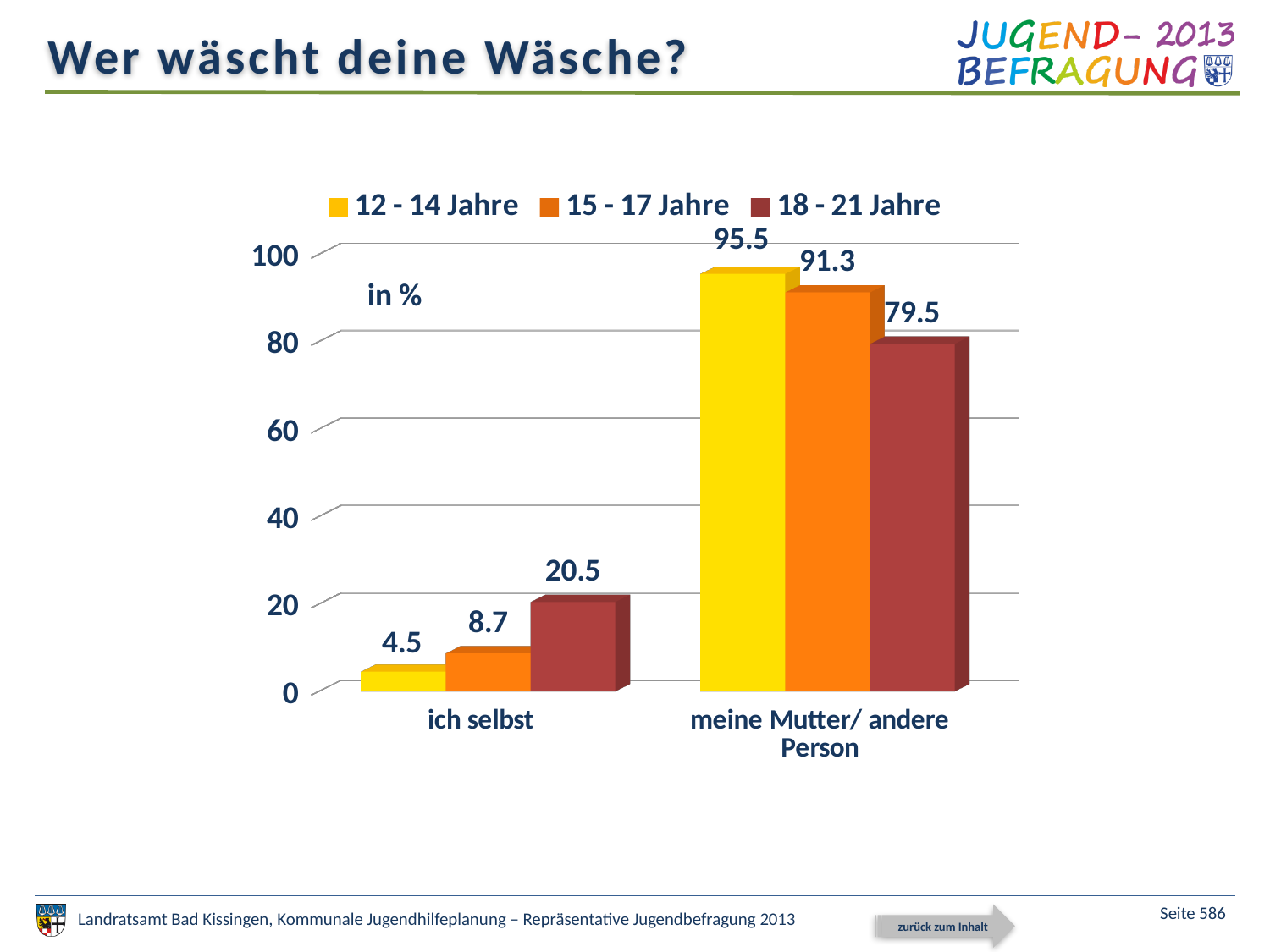
Which age group has the lowest value in the 'ich selbst' category? 12 - 14 Jahre Which age group has the highest value in the 'meine Mutter/ andere Person' category? 12 - 14 Jahre Which is larger: the '15 - 17 Jahre' value for 'ich selbst' or the '18 - 21 Jahre' value for 'ich selbst'? 18 - 21 Jahre What is the difference between the '12 - 14 Jahre' and '18 - 21 Jahre' values in the 'meine Mutter/ andere Person' category? 16 What is the difference between the '18 - 21 Jahre' and '15 - 17 Jahre' values in the 'ich selbst' category? 11.8 What is the value for '18 - 21 Jahre' in the 'meine Mutter/ andere Person' category? 79.5 What is the title of the slide? Wer wäscht deine Wäsche? How many categories are shown on the x axis? 2 What is the value for '15 - 17 Jahre' in the 'ich selbst' category? 8.7 How many series does the legend list? 3 What is the value for '12 - 14 Jahre' in the 'ich selbst' category? 4.5 What kind of chart is shown on the slide? bar chart